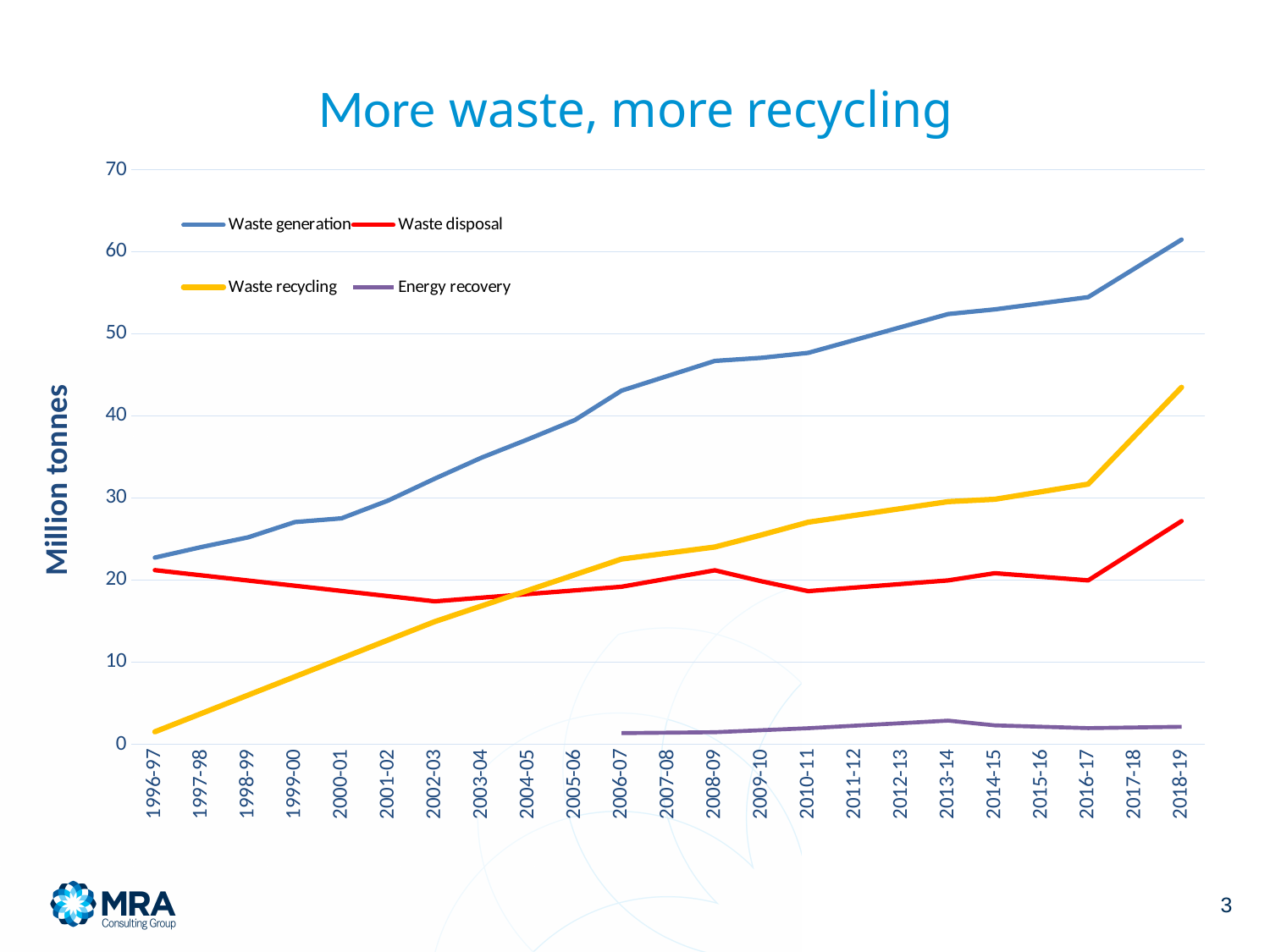
Is the value for Waste recycling in 1996-97 greater or less than 10? less Which series has the highest value in 2018-19? Waste generation Is the value for Waste generation in 2018-19 greater or less than 60? greater How many series does the legend list? 4 How many financial years are shown along the x axis? 23 What kind of chart is shown on the slide? Line chart Is the value for Waste disposal in 2018-19 greater or less than 20? greater Does the Waste generation line rise or fall from 1996-97 to 2018-19? Rises In 2018-19, which is larger: Waste recycling or Waste disposal? Waste recycling What is the label on the y axis? Million tonnes In 1996-97, which is larger: Waste disposal or Waste recycling? Waste disposal